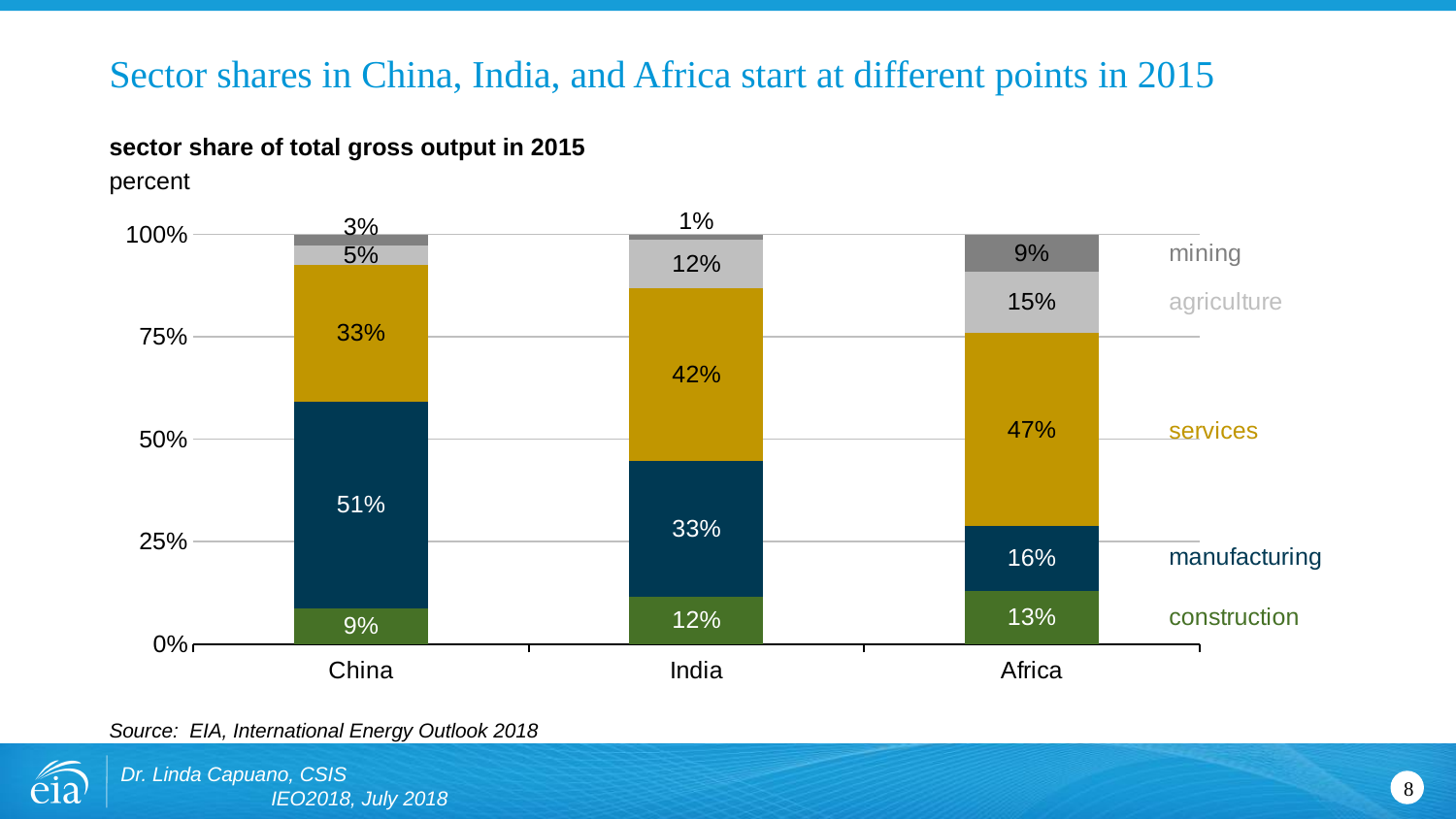
What is the title of the chart? sector share of total gross output in 2015 What is the manufacturing share of total gross output for China in 2015? 51% How many regions are shown on the x axis? 3 Which has the larger agriculture share, India or Africa? Africa How much larger is China's manufacturing share than India's? 18 percentage points Which region has the lowest mining share? India What is the mining share for Africa? 9% How many sectors (series) does the chart show? 5 What is the construction share for Africa? 13% Which region has the highest services share? Africa What kind of chart is this? Stacked bar chart What is the services share for India? 42%